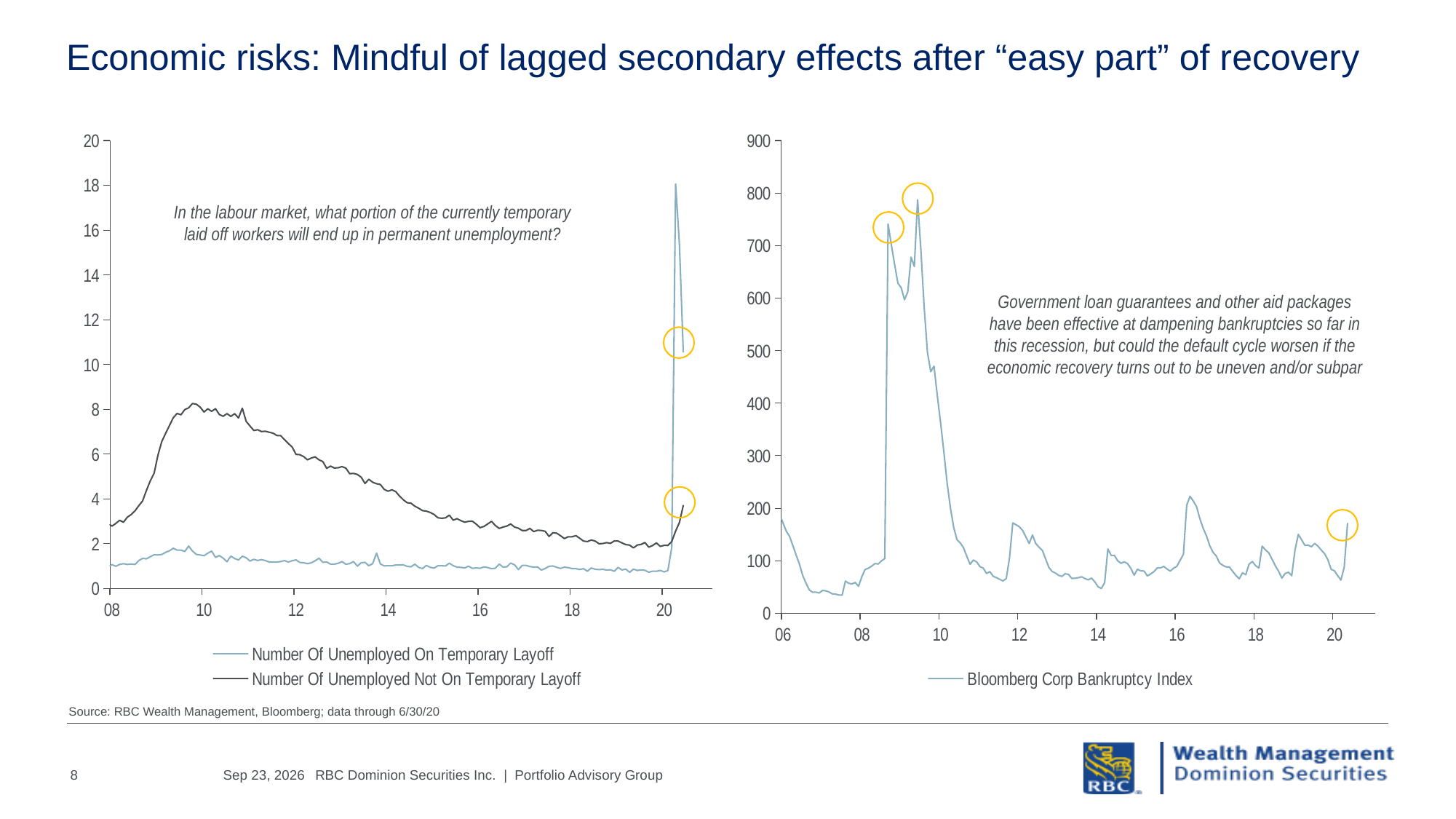
In the left chart, is the 2020 peak of Number Of Unemployed On Temporary Layoff greater or less than 16? greater How many series does the legend of the right chart list? 1 In the right chart, is the Bloomberg Corp Bankruptcy Index in 2007 greater or less than 100? less What kind of chart is the right chart (Bloomberg Corp Bankruptcy Index)? line chart In the right chart, does the Bloomberg Corp Bankruptcy Index rise or fall between 2009 and 2011? fall In the right chart, is the highest peak of the Bloomberg Corp Bankruptcy Index (around 2009) greater or less than 700? greater In the left chart, does Number Of Unemployed Not On Temporary Layoff rise or fall between 2010 and 2019? fall What is the name of the series shown in the right chart's legend? Bloomberg Corp Bankruptcy Index What kind of chart is the left chart on the slide? line chart In the left chart, which series is higher in 2012: Number Of Unemployed On Temporary Layoff or Number Of Unemployed Not On Temporary Layoff? Number Of Unemployed Not On Temporary Layoff How many series does the legend of the left chart list? 2